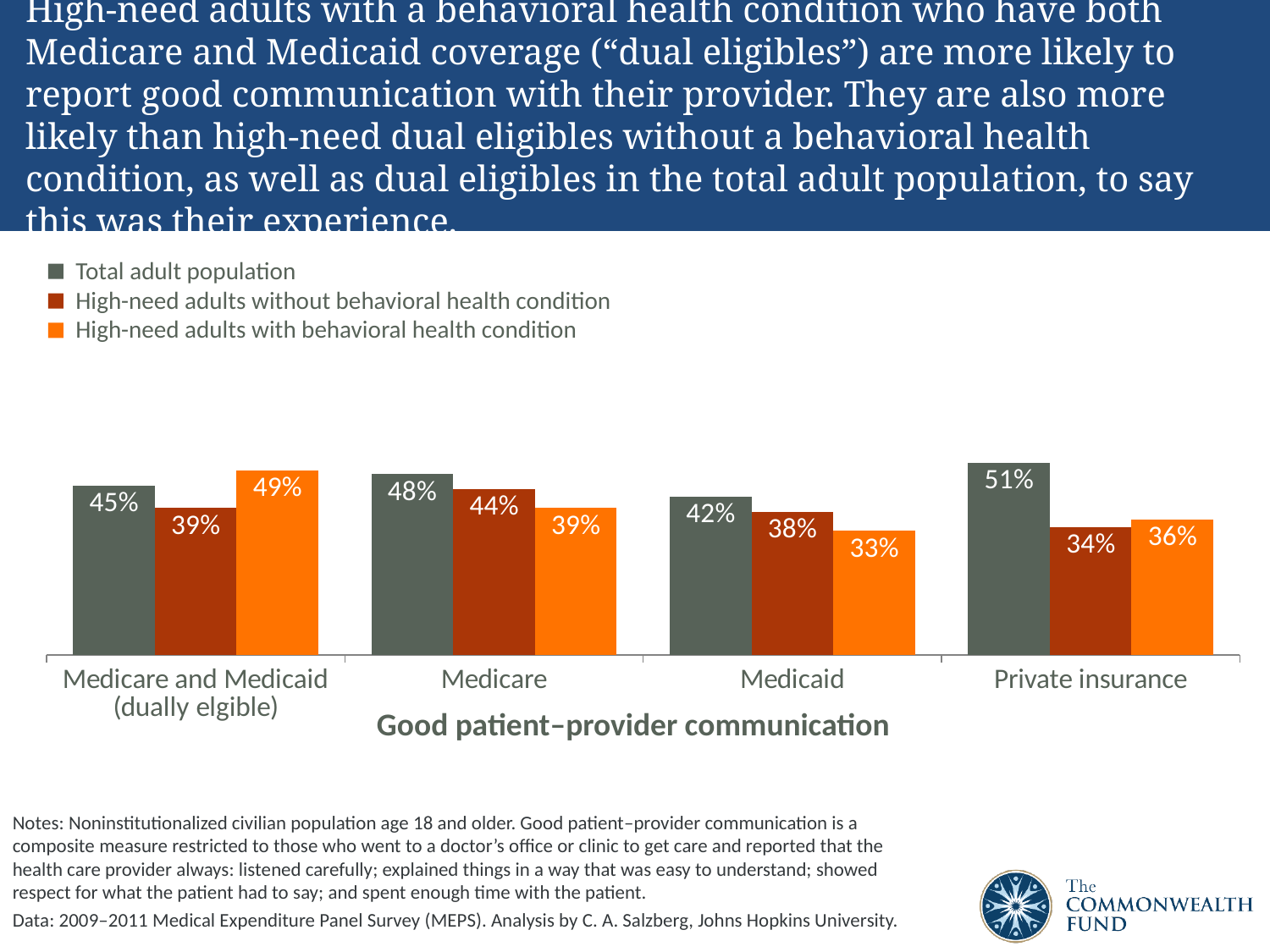
What is the value for High-need adults with behavioral health condition in the Medicare and Medicaid (dually eligible) category? 49% Which category has the highest value for Total adult population? Private insurance What is the difference between the Total adult population and High-need adults with behavioral health condition values in the Private insurance category? 15% Which category has the lowest value for High-need adults with behavioral health condition? Medicaid What is the value for High-need adults without behavioral health condition in the Medicaid category? 38% How many series does the legend list? 3 Which series is shown in orange in the legend? High-need adults with behavioral health condition How many categories are shown on the x axis? 4 What is the value for Total adult population in the Private insurance category? 51% What is the x-axis title of the chart? Good patient–provider communication What kind of chart is shown on the slide? Bar chart In the Medicare category, which is larger: the value for Total adult population or for High-need adults with behavioral health condition? Total adult population